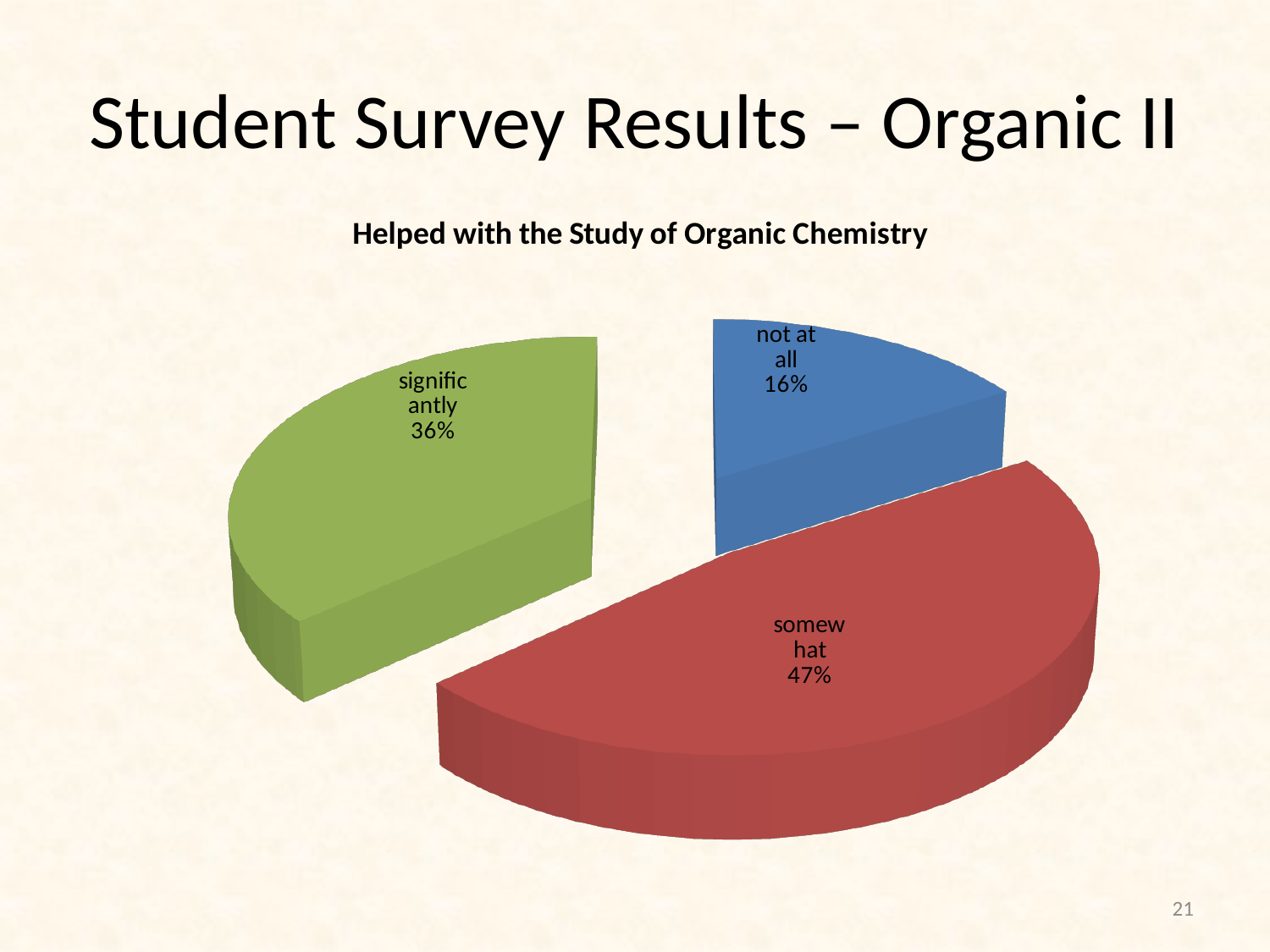
What percentage of the pie is the "significantly" slice? 36% What is the difference in percentage points between the "significantly" and "not at all" slices? 20 Which is larger, the "significantly" slice or the "not at all" slice? significantly What kind of chart is shown on the slide? pie chart What percentage of the pie is the "somewhat" slice? 47% Which slice is the largest? somewhat Which slice is the smallest? not at all What colour is the "somewhat" slice? red What percentage of the pie is the "not at all" slice? 16% What is the title of the chart? Helped with the Study of Organic Chemistry How many slices does the pie chart have? 3 What is the difference in percentage points between the "somewhat" and "significantly" slices? 11